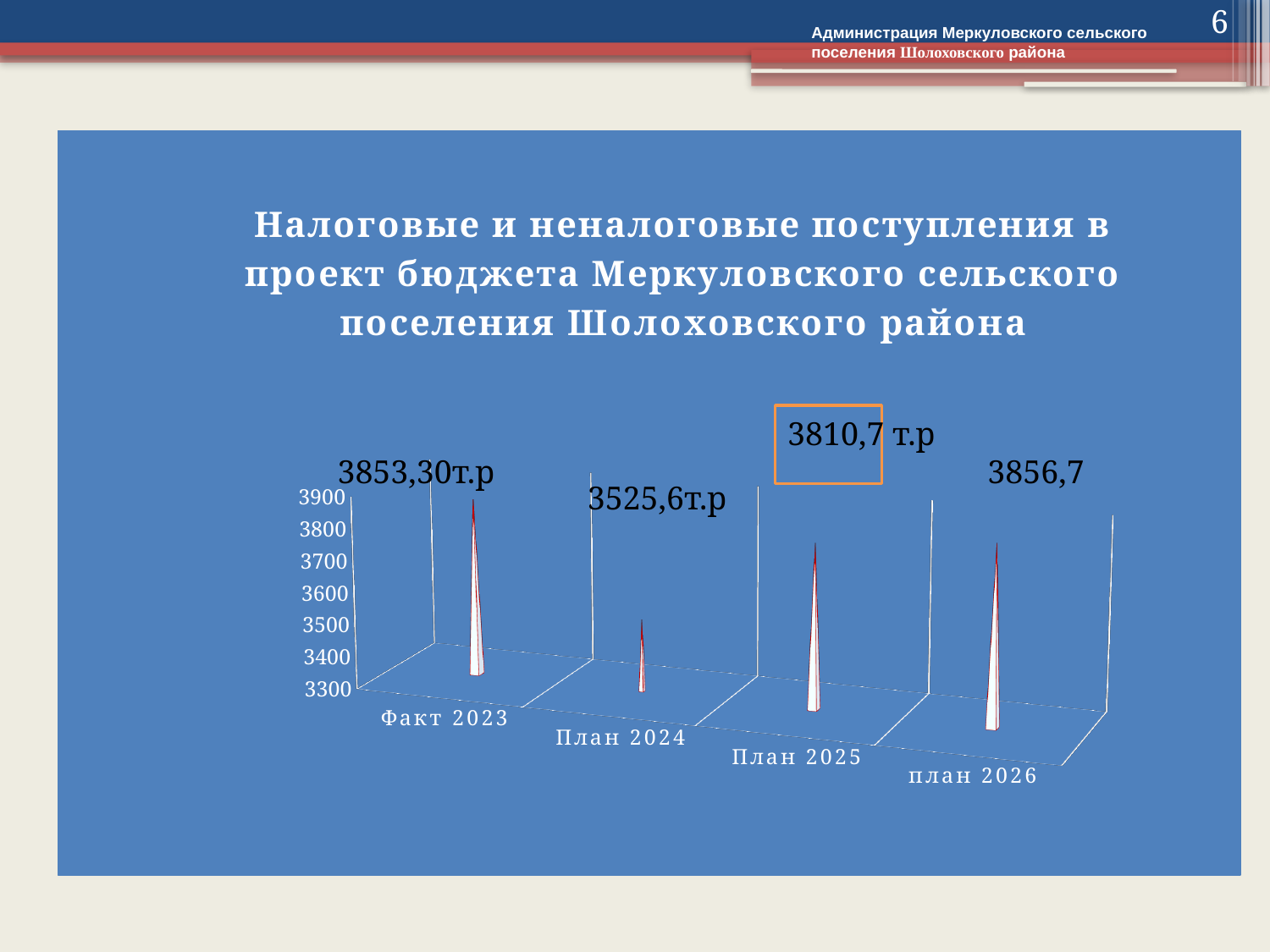
Which data label is highlighted with an orange box? 3810,7 т.р What is the value for План 2025? 3810,7 т.р What is the value for Факт 2023? 3853,30т.р How many categories are shown on the x axis? 4 What is the value for План 2024? 3525,6т.р What is the value for план 2026? 3856,7 Is the value for План 2024 greater or less than 3600? less What is the difference between the values for План 2025 and План 2024? 285,1 Which category has the lowest value? План 2024 What kind of chart is shown on the slide? bar chart What is the difference between the values for Факт 2023 and План 2024? 327,7 Which is larger, the value for План 2025 or the value for План 2024? План 2025